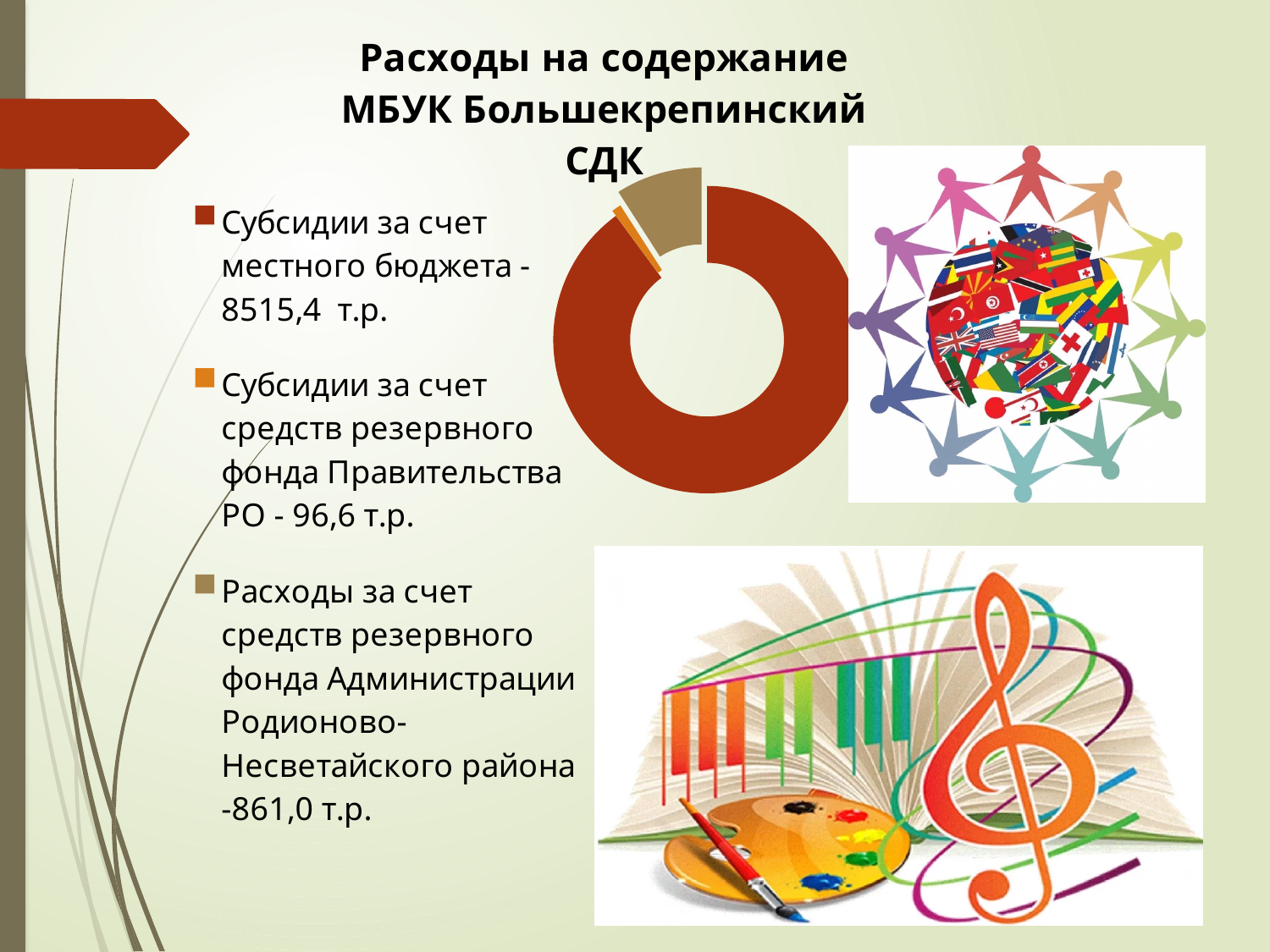
How many categories does the legend list for the chart? 3 What type of chart is shown on the slide? Doughnut (pie) chart How many slices does the doughnut chart have? 3 What is the difference between the local budget subsidies (8515,4) and the district administration reserve fund expenses (861,0)? 7654,4 т.р. What is the value for 'Субсидии за счет средств резервного фонда Правительства РО'? 96,6 т.р. What is the value for 'Субсидии за счет местного бюджета'? 8515,4 т.р. What is the total of all three categories shown in the chart? 9473,0 т.р. What is the value for 'Расходы за счет средств резервного фонда Администрации Родионово-Несветайского района'? 861,0 т.р. Which is larger: the reserve fund of the RO Government subsidies or the district administration reserve fund expenses? Расходы за счет средств резервного фонда Администрации Родионово-Несветайского района Which category has the largest slice of the chart? Субсидии за счет местного бюджета What colour is the slice for 'Субсидии за счет местного бюджета'? Dark red Which category has the smallest slice of the chart? Субсидии за счет средств резервного фонда Правительства РО